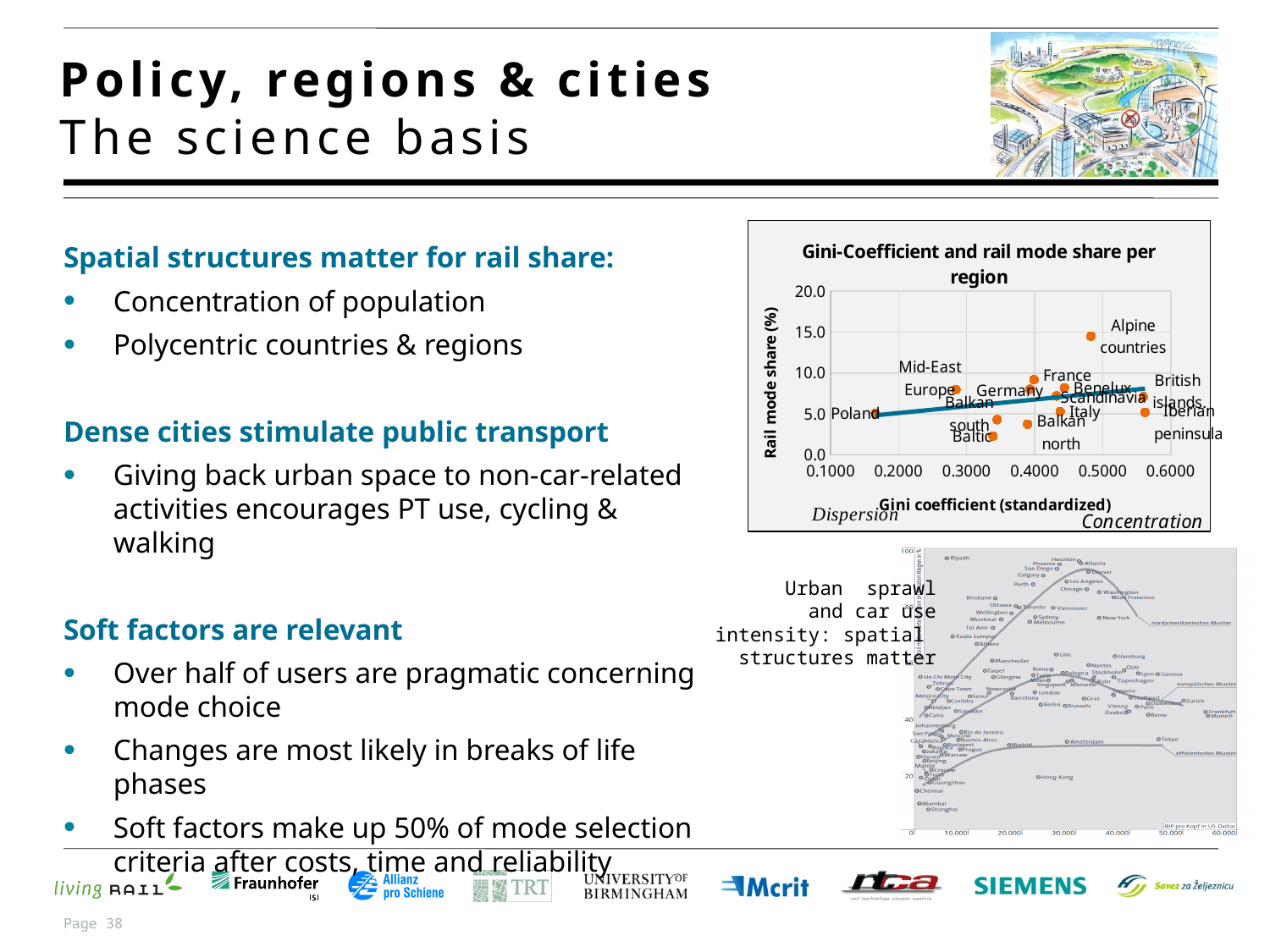
In the 'Gini-Coefficient and rail mode share per region' chart, is the Gini coefficient for Poland greater or less than 0.2000? less In the 'Gini-Coefficient and rail mode share per region' chart, which region has the highest rail mode share? Alpine countries What kind of chart is 'Gini-Coefficient and rail mode share per region'? scatter chart What is the title of the chart in the upper right of the slide? Gini-Coefficient and rail mode share per region In the 'Gini-Coefficient and rail mode share per region' chart, is the rail mode share for Baltic greater or less than 5.0? less In the 'Gini-Coefficient and rail mode share per region' chart, which has the higher rail mode share, Alpine countries or Poland? Alpine countries In the 'Gini-Coefficient and rail mode share per region' chart, is the rail mode share for Alpine countries greater or less than 10.0? greater In the 'Gini-Coefficient and rail mode share per region' chart, does the trend line rise or fall as the Gini coefficient increases? rise In the 'Gini-Coefficient and rail mode share per region' chart, which region has the lowest rail mode share? Baltic In the 'Gini-Coefficient and rail mode share per region' chart, what is the label of the vertical axis? Rail mode share (%)